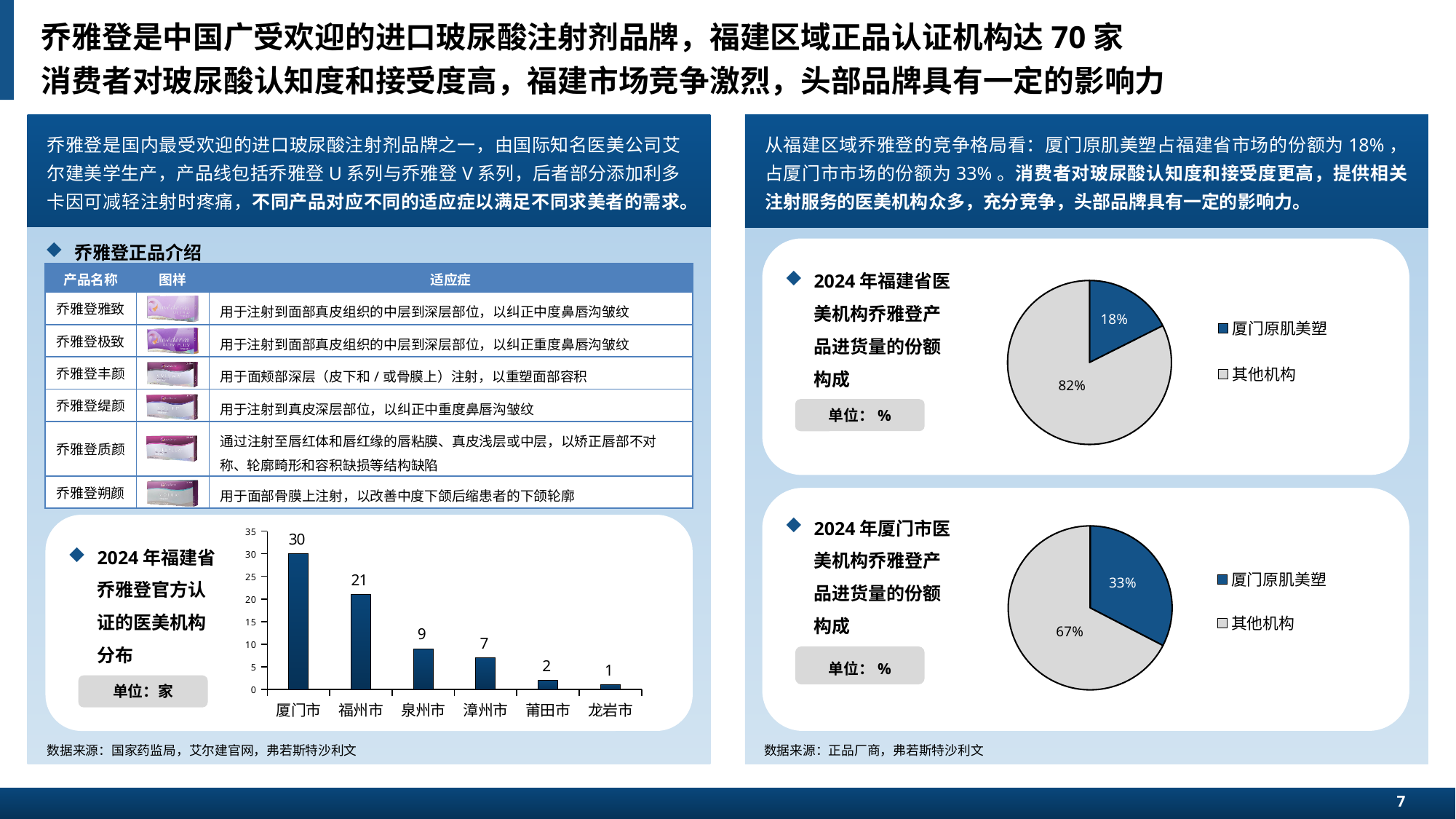
In the bar chart titled 2024年福建省乔雅登官方认证的医美机构分布, which city has the lowest value? 龙岩市 In the bar chart titled 2024年福建省乔雅登官方认证的医美机构分布, what is the difference between the values for 厦门市 and 福州市? 9 In the bar chart titled 2024年福建省乔雅登官方认证的医美机构分布, what is the value for 泉州市? 9 Is the share of 厦门原肌美塑 larger in the pie chart titled 2024年福建省医美机构乔雅登产品进货量的份额构成 or in the pie chart titled 2024年厦门市医美机构乔雅登产品进货量的份额构成? 2024年厦门市医美机构乔雅登产品进货量的份额构成 In the bar chart titled 2024年福建省乔雅登官方认证的医美机构分布, which city has the highest value? 厦门市 In the pie chart titled 2024年厦门市医美机构乔雅登产品进货量的份额构成, what share does 其他机构 hold? 67% In the pie chart titled 2024年厦门市医美机构乔雅登产品进货量的份额构成, how many entries does the legend list? 2 In the pie chart titled 2024年福建省医美机构乔雅登产品进货量的份额构成, what share does 厦门原肌美塑 hold? 18% In the bar chart titled 2024年福建省乔雅登官方认证的医美机构分布, how many cities are shown on the x axis? 6 In the bar chart titled 2024年福建省乔雅登官方认证的医美机构分布, do the values rise or fall from left to right along the x axis? fall What kind of chart is the one titled 2024年福建省乔雅登官方认证的医美机构分布? bar chart In the bar chart titled 2024年福建省乔雅登官方认证的医美机构分布, what is the value for 厦门市? 30